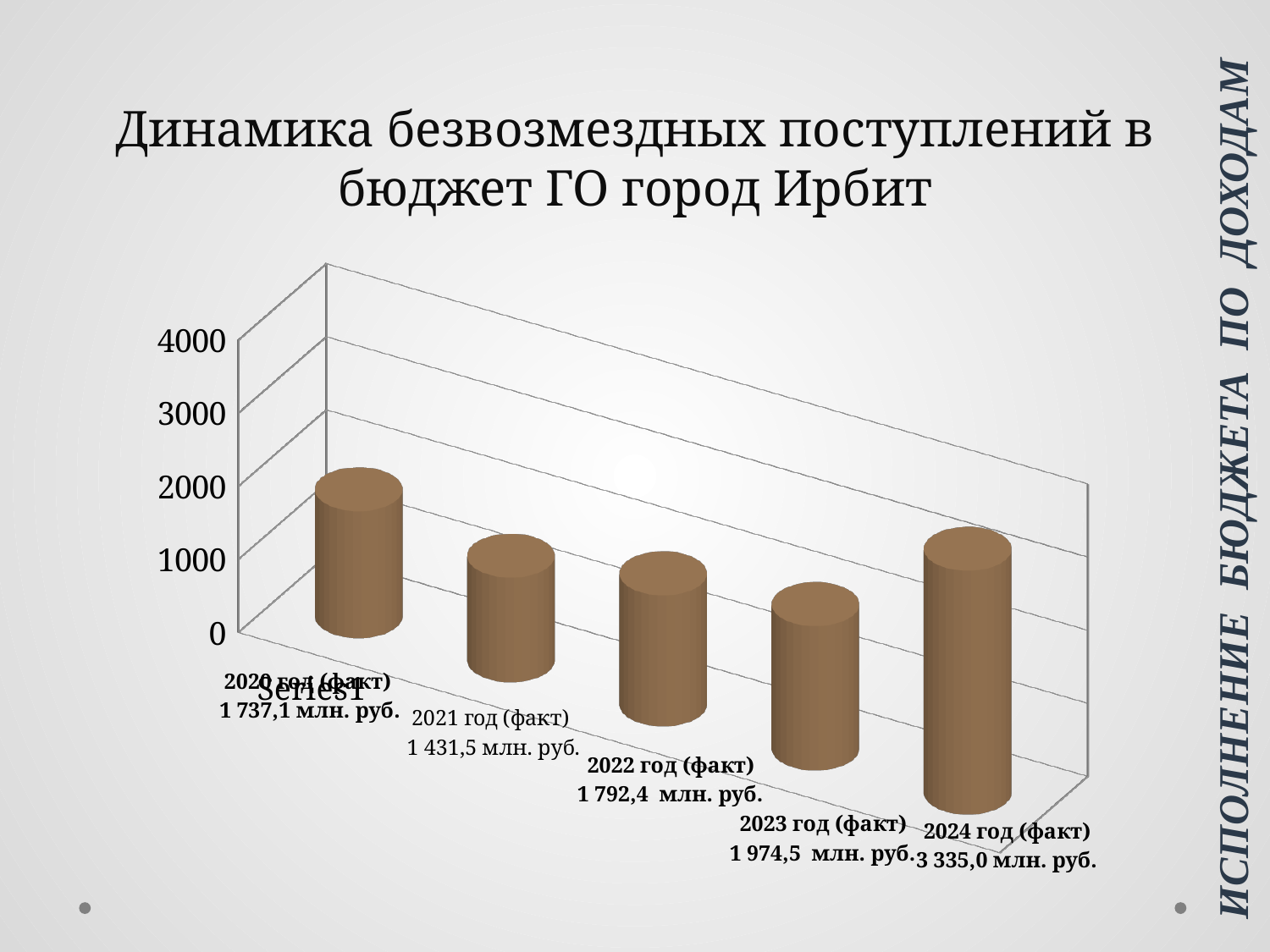
What is the value for 2021 год (факт)? 1 431,5 млн. руб. What kind of chart is shown on the slide? bar chart What is the value for 2023 год (факт)? 1 974,5 млн. руб. What is the value for 2022 год (факт)? 1 792,4 млн. руб. Which year has the lowest value? 2021 год (факт) Which is larger, the value for 2020 год (факт) or 2022 год (факт)? 2022 год (факт) How many years are shown in the chart? 5 Is the value for 2024 год (факт) greater or less than 3000? greater Which year has the highest value? 2024 год (факт) What is the value for 2024 год (факт)? 3 335,0 млн. руб. What is the difference between the values for 2024 год (факт) and 2023 год (факт)? 1 360,5 млн. руб. What is the title of the chart? Динамика безвозмездных поступлений в бюджет ГО город Ирбит